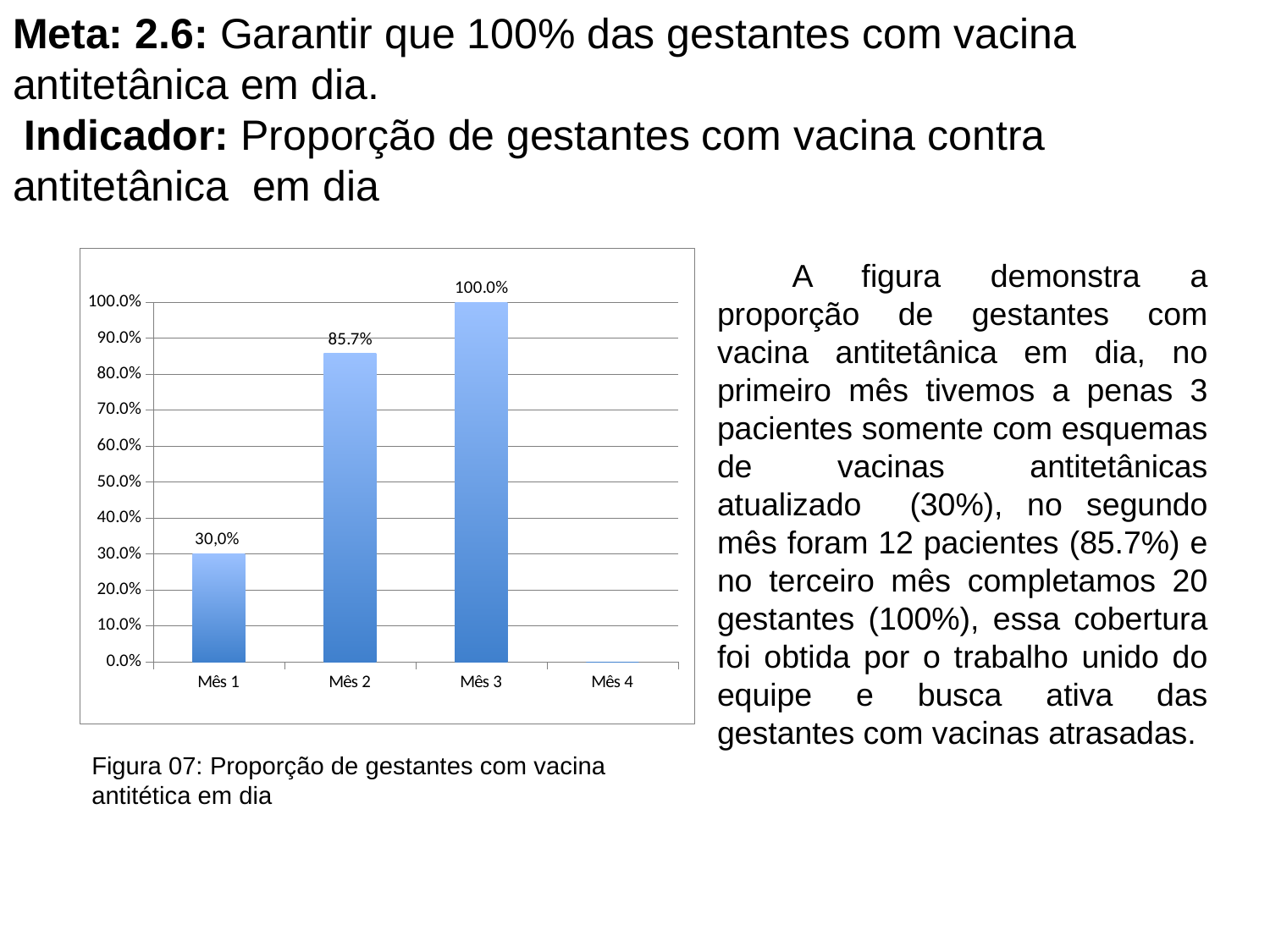
What is the difference between the values for Mês 2 and Mês 1? 55.7% Is the value for Mês 1 greater or less than 40.0%? less What is the difference between the values for Mês 3 and Mês 2? 14.3% Which is larger, the value for Mês 1 or the value for Mês 2? Mês 2 Do the values rise or fall from Mês 1 to Mês 3? Rise What is the value for Mês 2? 85.7% What is the value for Mês 3? 100.0% Which month has the highest value? Mês 3 What is the value for Mês 1? 30,0% How many categories are shown on the x axis? 4 What kind of chart is shown? Bar chart Is the value for Mês 2 greater or less than 80.0%? greater